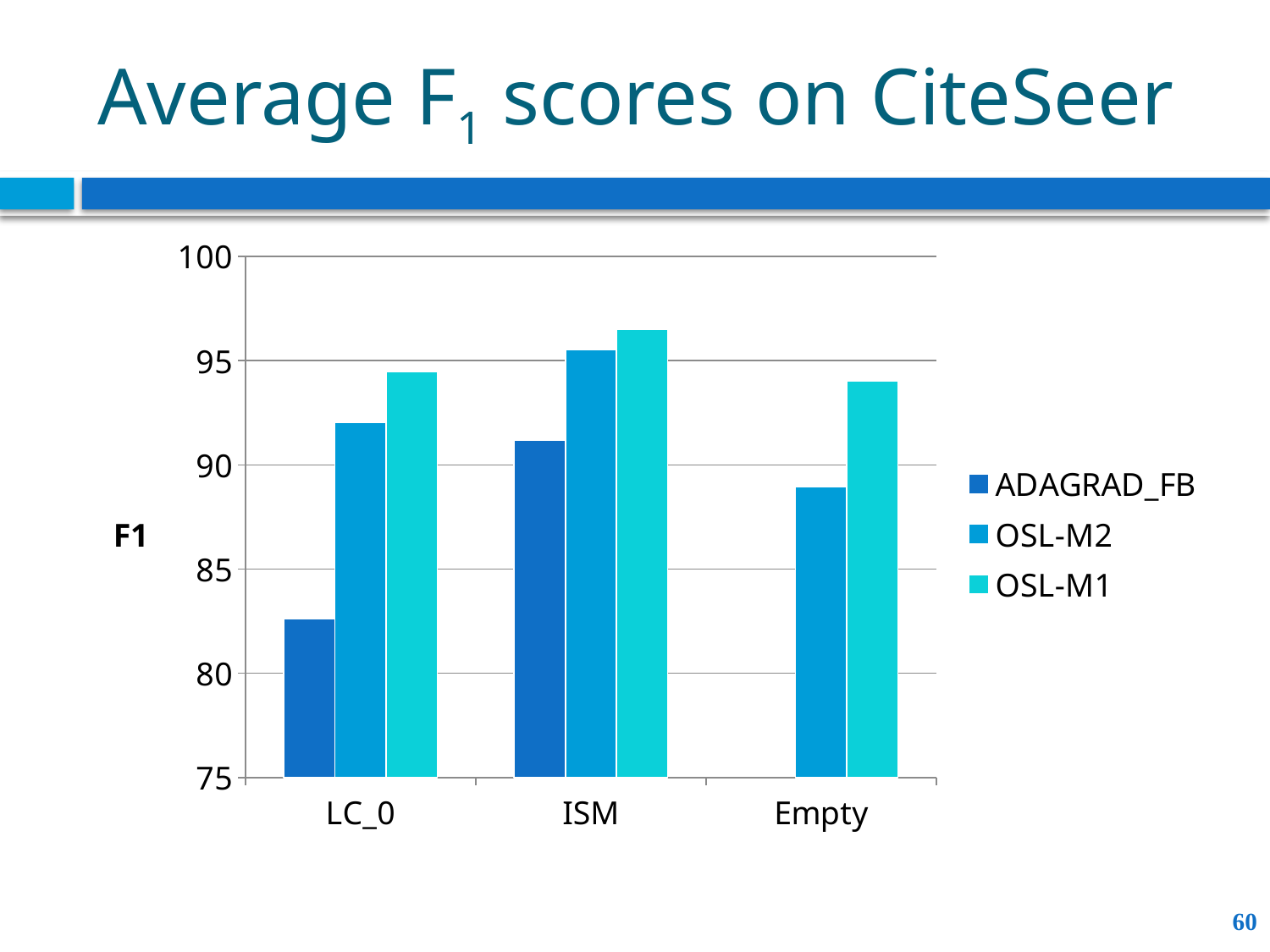
Is the value for OSL-M1 in the ISM category greater or less than 95? greater Is the value for OSL-M2 in the Empty category greater or less than 90? less What is the label on the y axis of the chart? F1 How many series does the legend list? 3 What kind of chart is shown on the slide? bar chart Which series has the highest value for the ISM category? OSL-M1 Which category has the highest ADAGRAD_FB value? ISM Which category has no ADAGRAD_FB bar? Empty How many categories are shown on the x axis? 3 Which series has the lowest value for the LC_0 category? ADAGRAD_FB Which is larger, the OSL-M2 value for LC_0 or the OSL-M2 value for ISM? OSL-M2 value for ISM Is the value for ADAGRAD_FB in the LC_0 category greater or less than 85? less